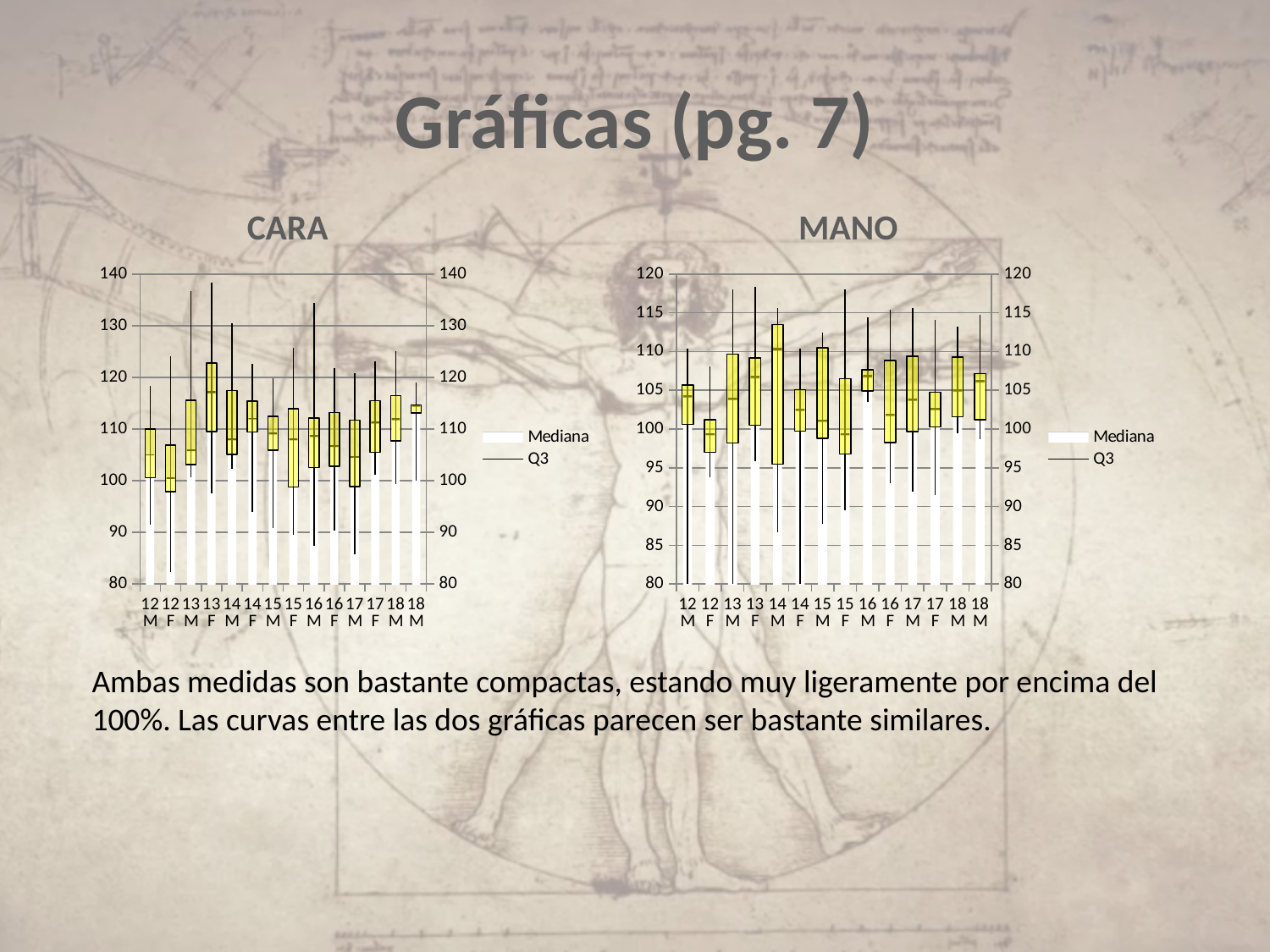
In the MANO chart, is the top of the box (Q3) for 14 M greater or less than 110? greater What is the title of the chart on the left of the slide? CARA In the CARA chart, which has the higher median (Mediana): 13 F or 12 F? 13 F How many categories are shown along the x axis of the CARA chart? 14 In the CARA chart, is the median (Mediana) for 12 M greater or less than 100? greater What two entries does the legend of the MANO chart list? Mediana and Q3 How many categories are shown along the x axis of the MANO chart? 14 In the MANO chart, which has the higher median (Mediana): 14 M or 12 F? 14 M In the MANO chart, is the median (Mediana) for 13 M greater or less than 100? greater How many series does the legend of the CARA chart list? 2 What kind of chart is the CARA chart? Box plot